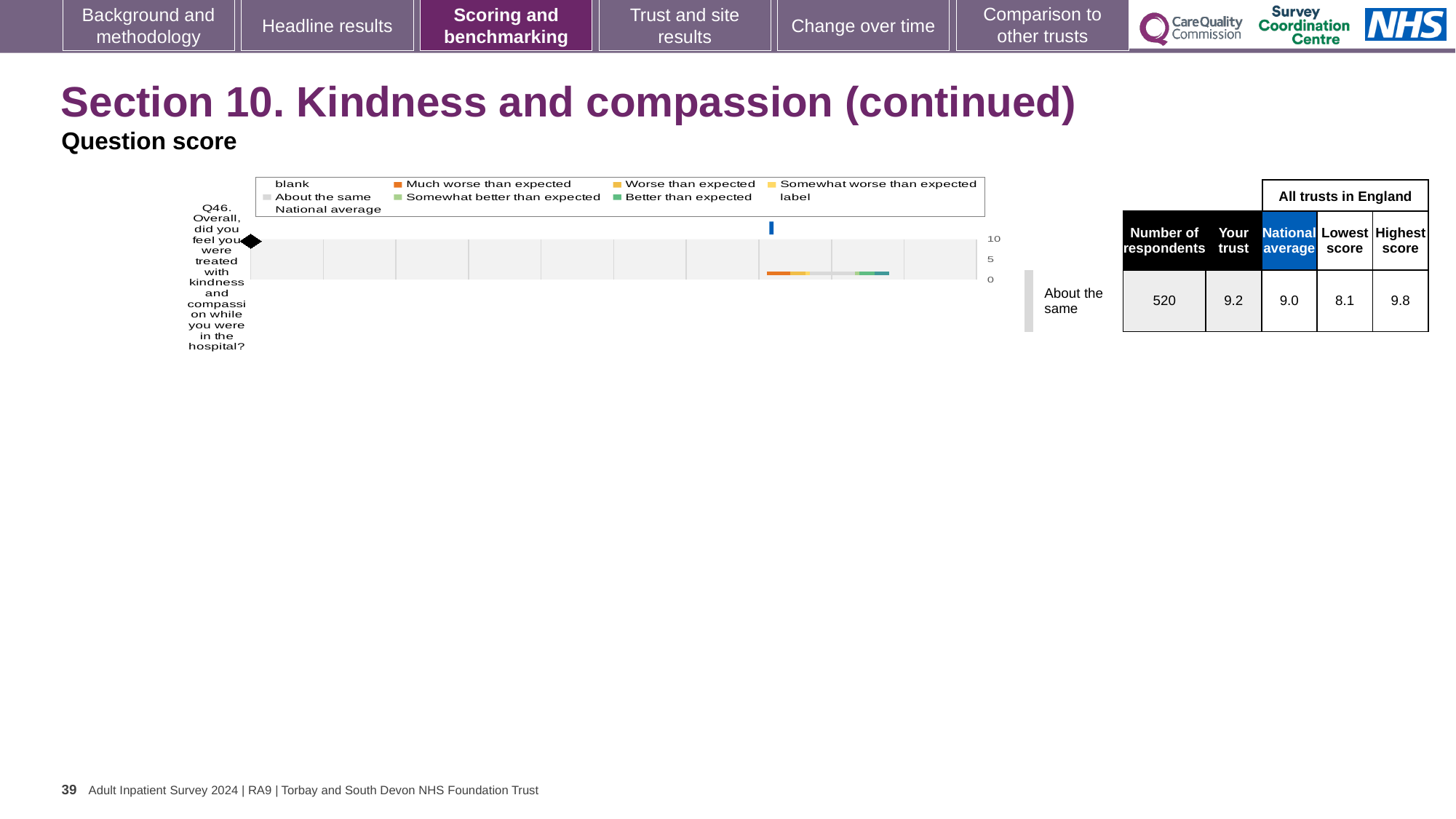
Which is larger for Q46: the 'Your trust' score or the national average? Your trust According to the table next to the chart, what is the national average score for Q46? 9.0 How many respondents answered Q46, according to the table next to the chart? 520 What is the highest tick value shown on the chart's axis? 10 What kind of chart is shown on the slide? bar chart Which question number is plotted on the chart? Q46 According to the table next to the chart, what is the highest score among all trusts in England for Q46? 9.8 According to the table next to the chart, what is the lowest score among all trusts in England for Q46? 8.1 Which benchmarking category is the trust's Q46 result placed in, as labelled beside the chart? About the same According to the table next to the chart, what is the 'Your trust' score for Q46? 9.2 What is the difference between the highest score and the lowest score for Q46 in the table next to the chart? 1.7